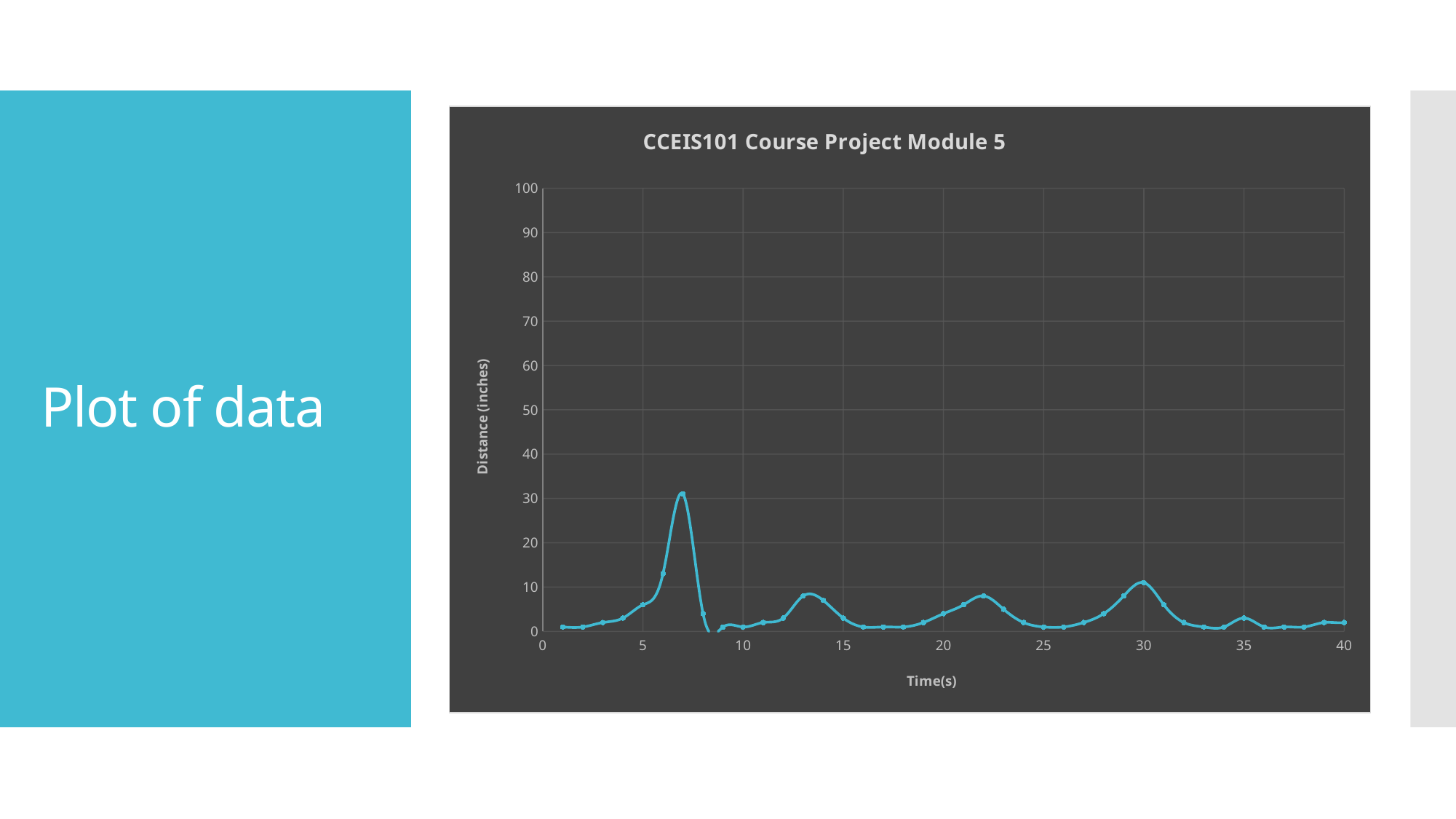
Is the distance at time 25 s greater or less than 5? less What kind of chart is shown on the slide? line chart Does the distance rise or fall between time 5 s and time 7 s? rise At which time (in seconds) does the distance reach its highest value? 7 Is the distance at time 7 s greater or less than 20? greater Is the distance at time 30 s greater or less than 5? greater What is the title of the chart? CCEIS101 Course Project Module 5 What is the label of the vertical axis of the chart? Distance (inches) Which has the larger distance: time 7 s or time 22 s? time 7 s Which has the larger distance: time 22 s or time 35 s? time 22 s